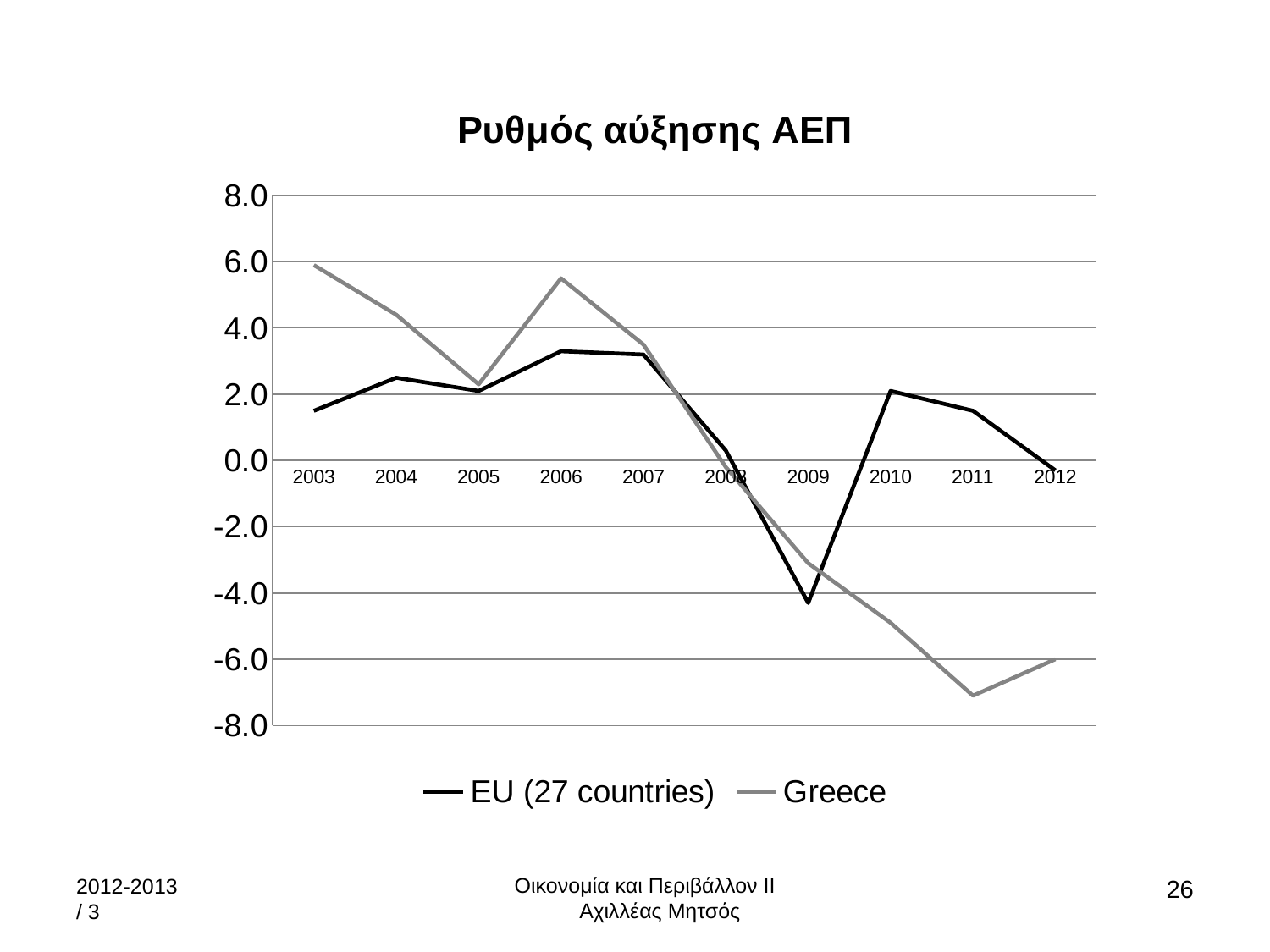
Is the value for EU (27 countries) in 2009 greater or less than -4.0? less Is the value for Greece in 2011 greater or less than -6.0? less Does the Greece series rise or fall from 2007 to 2011? fall In which year does the Greece series reach its lowest value? 2011 Is the value for Greece in 2003 greater or less than 4.0? greater How many years are plotted along the x axis? 10 What kind of chart is shown on the slide? line chart In which year does the EU (27 countries) series reach its lowest value? 2009 Which series has the higher value in 2011, EU (27 countries) or Greece? EU (27 countries) How many series does the legend list? 2 Which series has the higher value in 2003, EU (27 countries) or Greece? Greece What is the title of the chart? Ρυθμός αύξησης ΑΕΠ